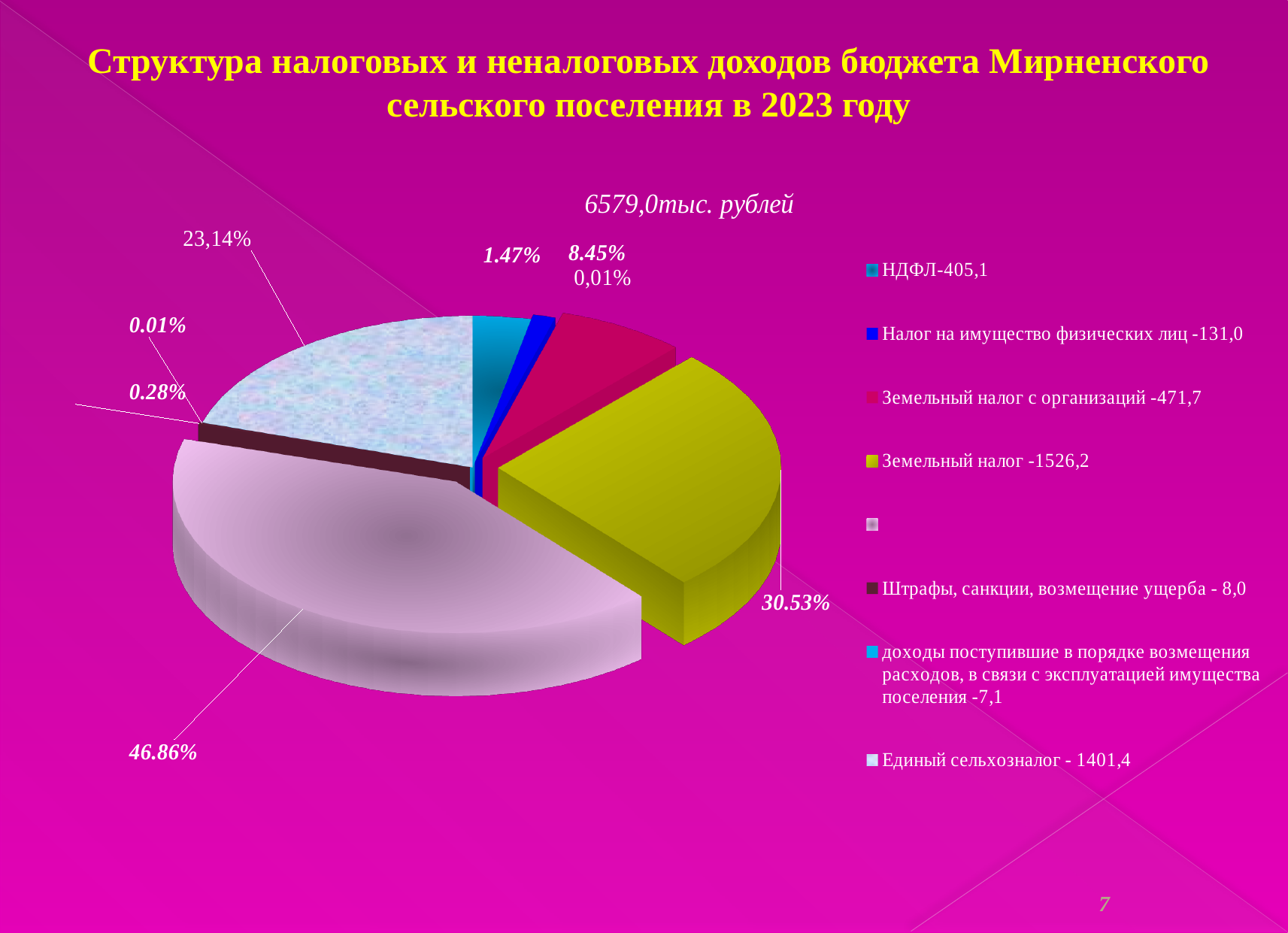
What value is given in the legend for Единый сельхозналог? 1401,4 What is the total amount shown above the pie chart? 6579,0тыс. рублей Which has the larger legend value, Земельный налог or Единый сельхозналог? Земельный налог What percentage label is shown on the largest slice of the pie? 46.86% What value is given in the legend for Налог на имущество физических лиц? 131,0 What value is given in the legend for Штрафы, санкции, возмещение ущерба? 8,0 What is the difference between the legend values for НДФЛ and Налог на имущество физических лиц? 274,1 What kind of chart is shown on the slide? pie chart What percentage is shown for the Единый сельхозналог slice? 23,14% What value is given in the legend for Земельный налог с организаций? 471,7 What value is given in the legend for НДФЛ? 405,1 What percentage is shown for the yellow slice (Земельный налог)? 30.53%